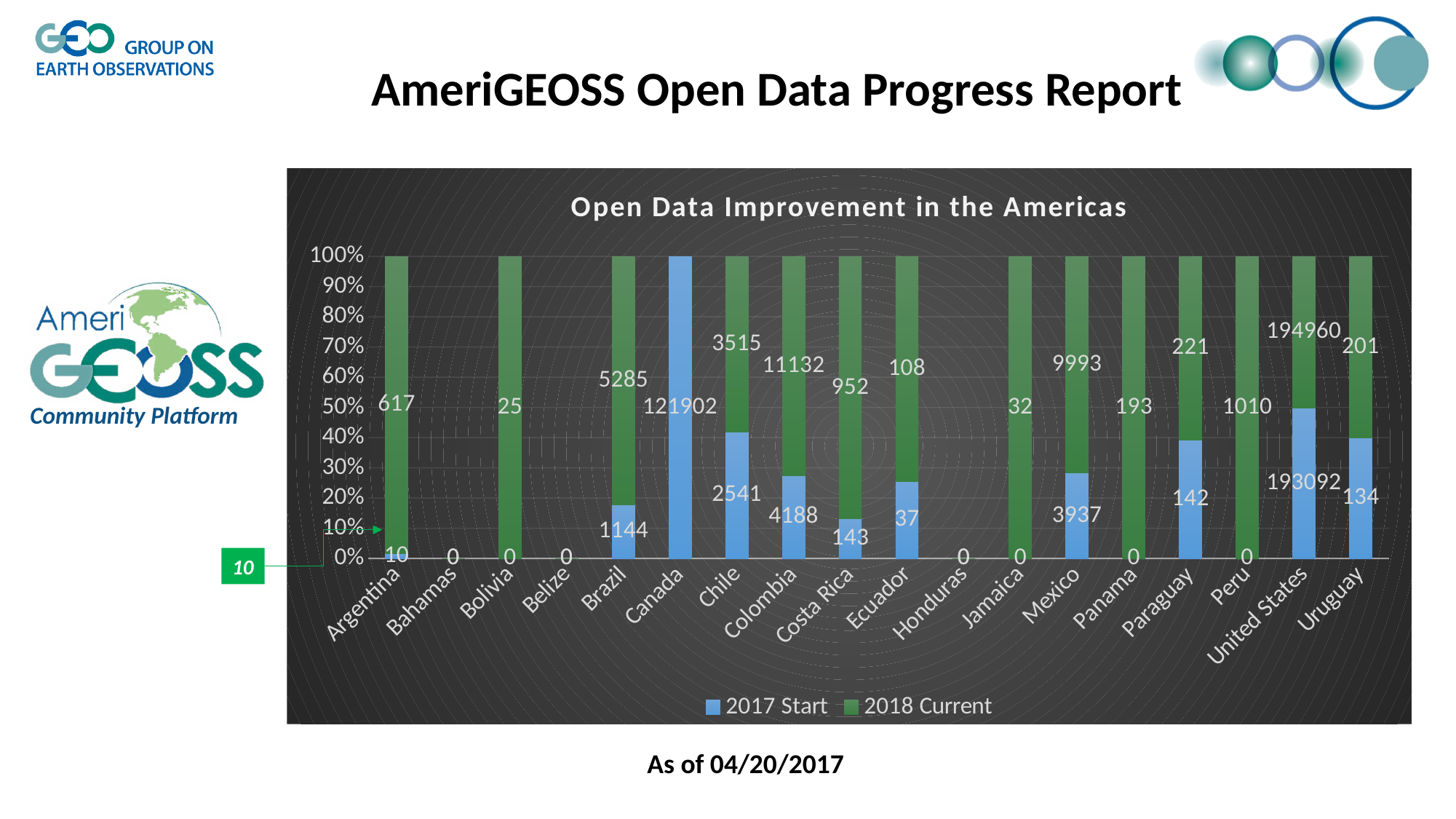
What is the 2018 Current value for Peru? 1010 What type of chart is shown on the slide? Stacked bar chart How many series does the chart legend list? 2 What is the 2017 Start value for Colombia? 4188 How many countries are shown on the x axis of the chart? 18 What is the title of the chart? Open Data Improvement in the Americas Which series is shown in green in the chart? 2018 Current What is the 2018 Current value for Brazil? 5285 What is the 2017 Start value for Canada? 121902 Which country has the highest 2018 Current value? United States Which is larger, the 2018 Current value for Chile or the 2018 Current value for Colombia? Colombia What is the difference between the 2018 Current and 2017 Start values for Mexico? 6056